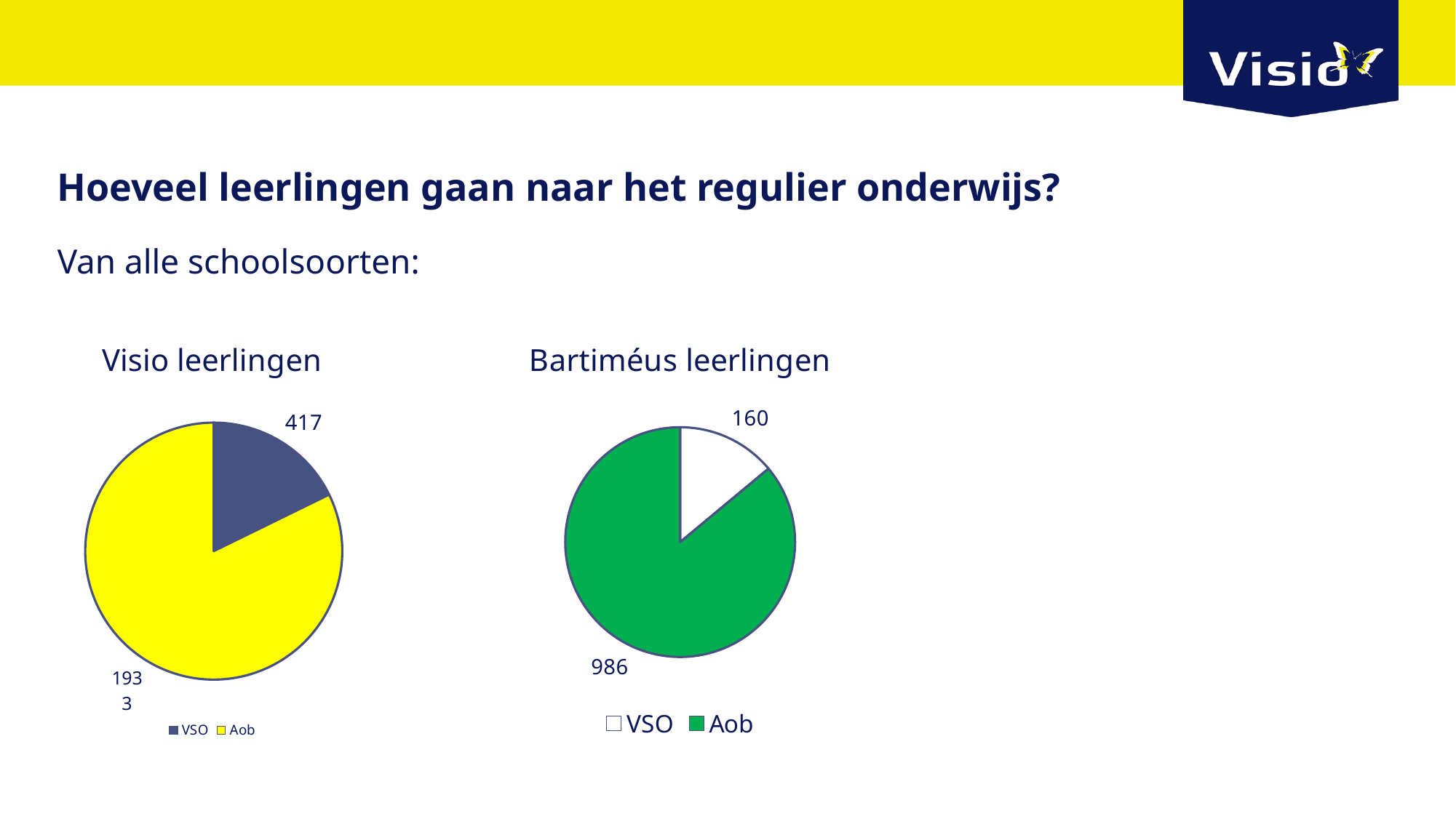
In the Visio leerlingen chart, which category has the smallest slice? VSO In the Bartiméus leerlingen chart, what colour is the Aob slice? Green How many slices does the Visio leerlingen pie chart have? 2 In the Bartiméus leerlingen chart, what is the value for Aob? 986 In the Visio leerlingen chart, which is larger, VSO or Aob? Aob In the Visio leerlingen chart, what is the value for VSO? 417 In the Bartiméus leerlingen chart, what is the value for VSO? 160 In the Visio leerlingen chart, what is the value for Aob? 1933 What kind of chart is the Bartiméus leerlingen chart? Pie chart How many entries does the legend of the Bartiméus leerlingen chart list? 2 In the Bartiméus leerlingen chart, which category has the largest slice? Aob In the Bartiméus leerlingen chart, what is the difference between Aob and VSO? 826